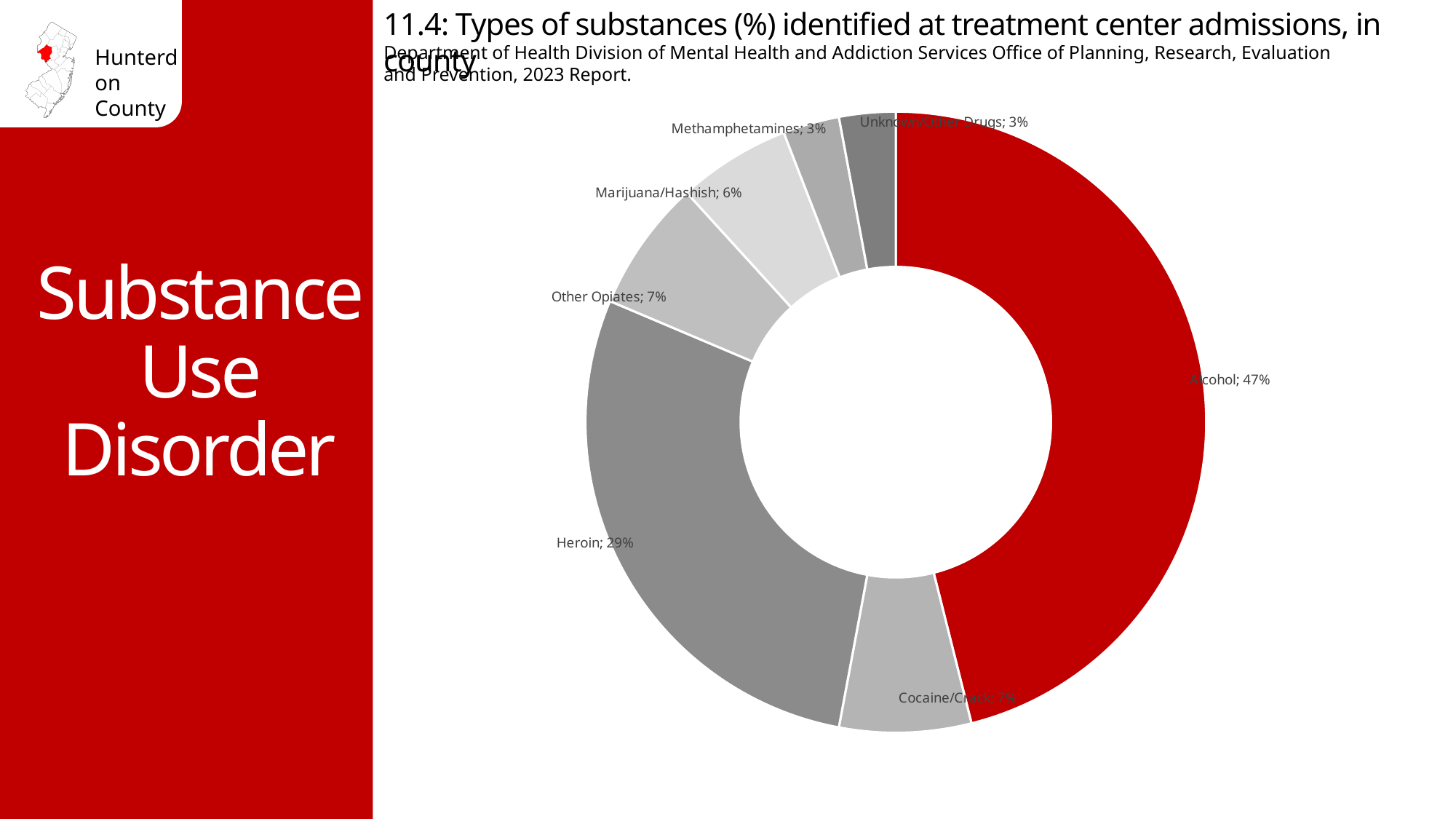
What percentage is shown for Cocaine/Crack? 7% How many substance categories are shown in the chart? 7 What percentage is shown for Other Opiates? 7% What is the combined percentage for Methamphetamines and Unknown/Other Drugs? 6% What percentage of treatment center admissions is attributed to Alcohol? 47% What percentage is shown for Heroin? 29% Which slice of the chart is coloured red? Alcohol What percentage is shown for Marijuana/Hashish? 6% What is the difference in percentage points between Alcohol and Heroin? 18 What kind of chart is shown on the slide? Pie (doughnut) chart Which is larger, the share for Heroin or the share for Cocaine/Crack? Heroin Which substance has the largest share of admissions? Alcohol